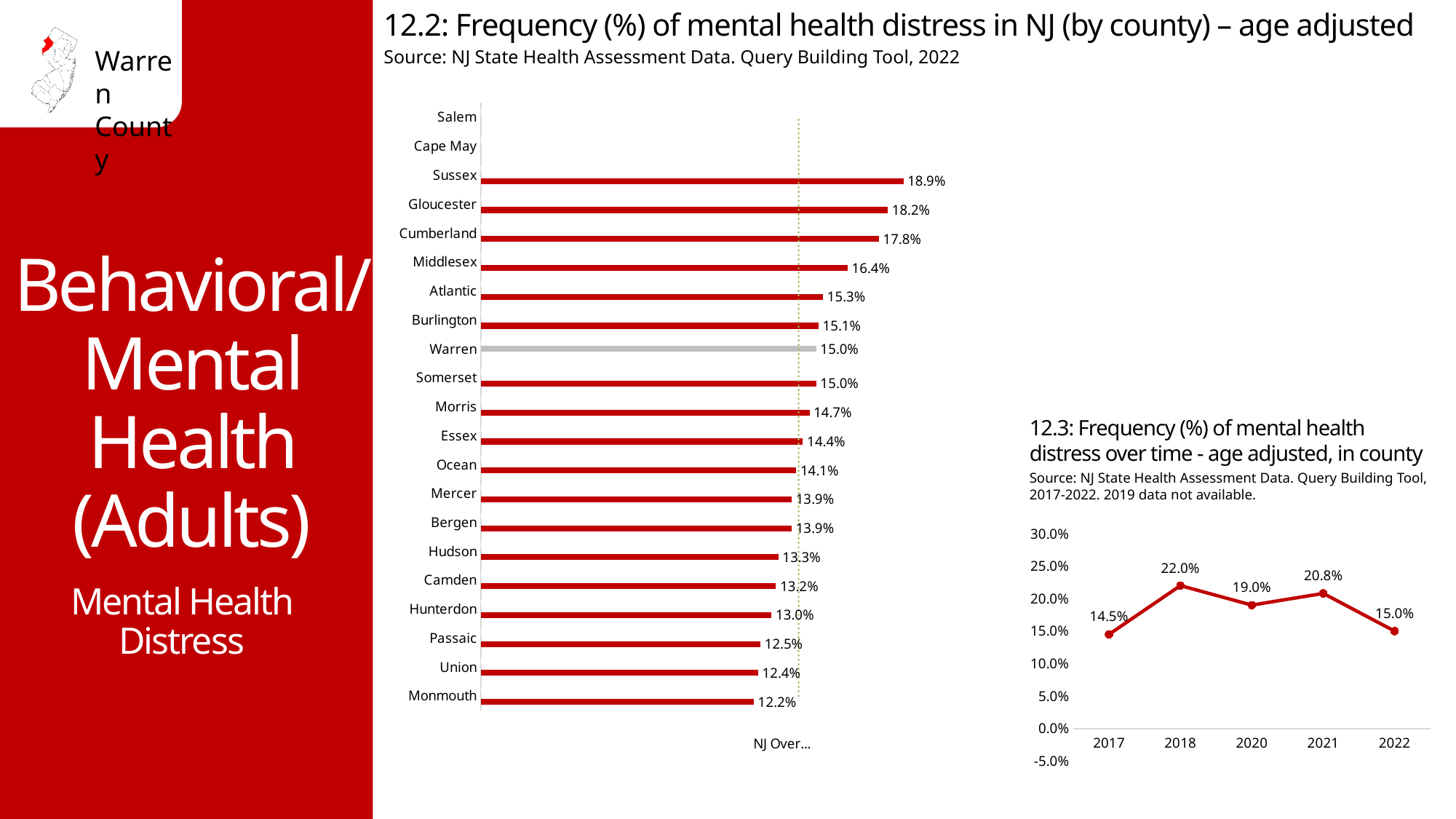
In chart 12.2, which county with a plotted bar has the lowest value? Monmouth In chart 12.3, which year has the lowest value? 2017 In chart 12.3, what is the value for 2018? 22.0% In chart 12.2, which county has the highest frequency of mental health distress? Sussex In chart 12.3, how many years are plotted? 5 What kind of chart is chart 12.2? Bar chart In chart 12.2, what is the difference between the values for Gloucester and Hunterdon? 5.2% In chart 12.2, what is the frequency of mental health distress for Warren County? 15.0% In chart 12.3, what is the difference between the 2021 and 2022 values? 5.8% What kind of chart is chart 12.3? Line chart In chart 12.2, what is the value shown for Sussex? 18.9% In chart 12.2, which has a higher value, Middlesex or Atlantic? Middlesex